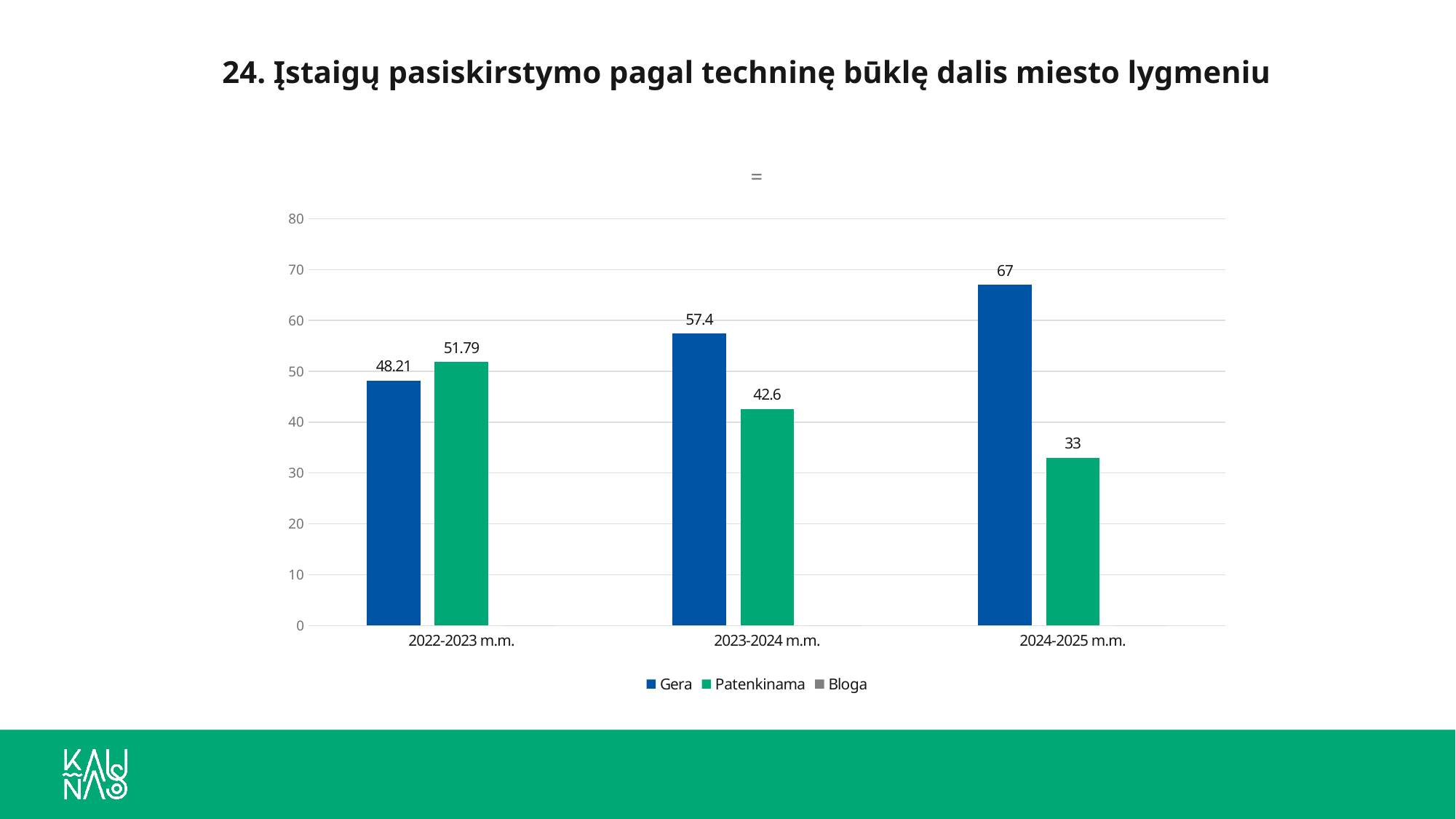
How many school years are shown on the x axis? 3 What is the value for Gera in 2024-2025 m.m.? 67 Which is larger in 2022-2023 m.m., Gera or Patenkinama? Patenkinama In which school year is the Patenkinama value lowest? 2024-2025 m.m. What is the value for Patenkinama in 2024-2025 m.m.? 33 What is the difference between the Gera values in 2023-2024 m.m. and 2022-2023 m.m.? 9.19 In which school year is the Gera value highest? 2024-2025 m.m. What is the value for Patenkinama in 2023-2024 m.m.? 42.6 What is the difference between the Gera and Patenkinama values in 2024-2025 m.m.? 34 What is the value for Gera in 2022-2023 m.m.? 48.21 What kind of chart is shown on the slide? Bar chart How many series does the legend list? 3